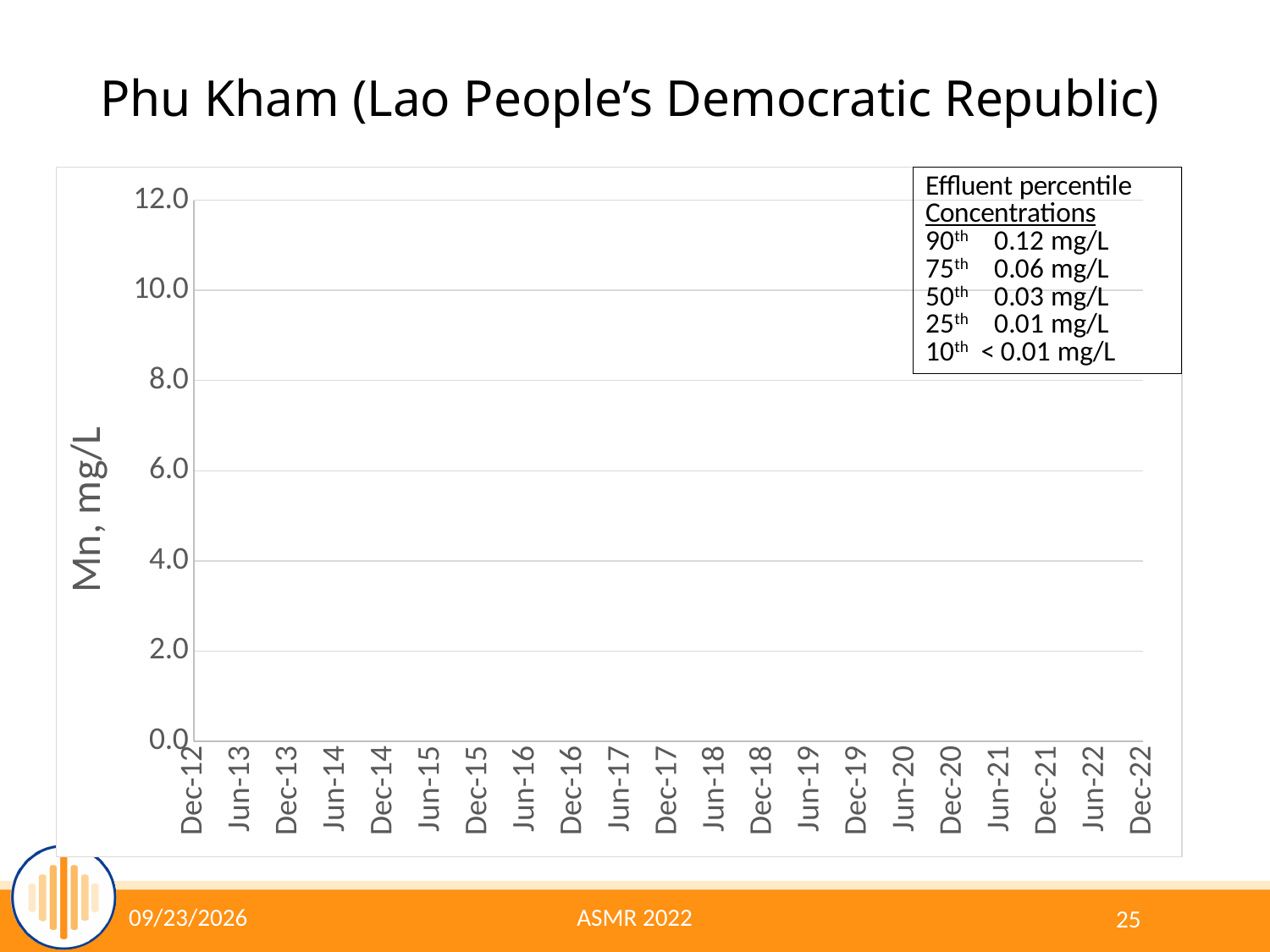
How many date labels are shown along the chart's x-axis? 21 What is the y-axis label of the chart? Mn, mg/L According to the effluent percentile box on the chart, what is the 90th percentile Mn concentration? 0.12 mg/L According to the effluent percentile box on the chart, what is the 25th percentile Mn concentration? 0.01 mg/L According to the effluent percentile box on the chart, what is the 50th percentile Mn concentration? 0.03 mg/L Which is larger in the effluent percentile box, the 75th percentile or the 50th percentile Mn concentration? 75th percentile What is the difference between the 90th and 75th percentile Mn concentrations listed in the effluent percentile box? 0.06 mg/L What is the maximum value shown on the chart's y-axis? 12.0 According to the effluent percentile box on the chart, what is the 10th percentile Mn concentration? < 0.01 mg/L Which percentile listed in the effluent percentile box has the highest Mn concentration? 90th According to the effluent percentile box on the chart, what is the 75th percentile Mn concentration? 0.06 mg/L